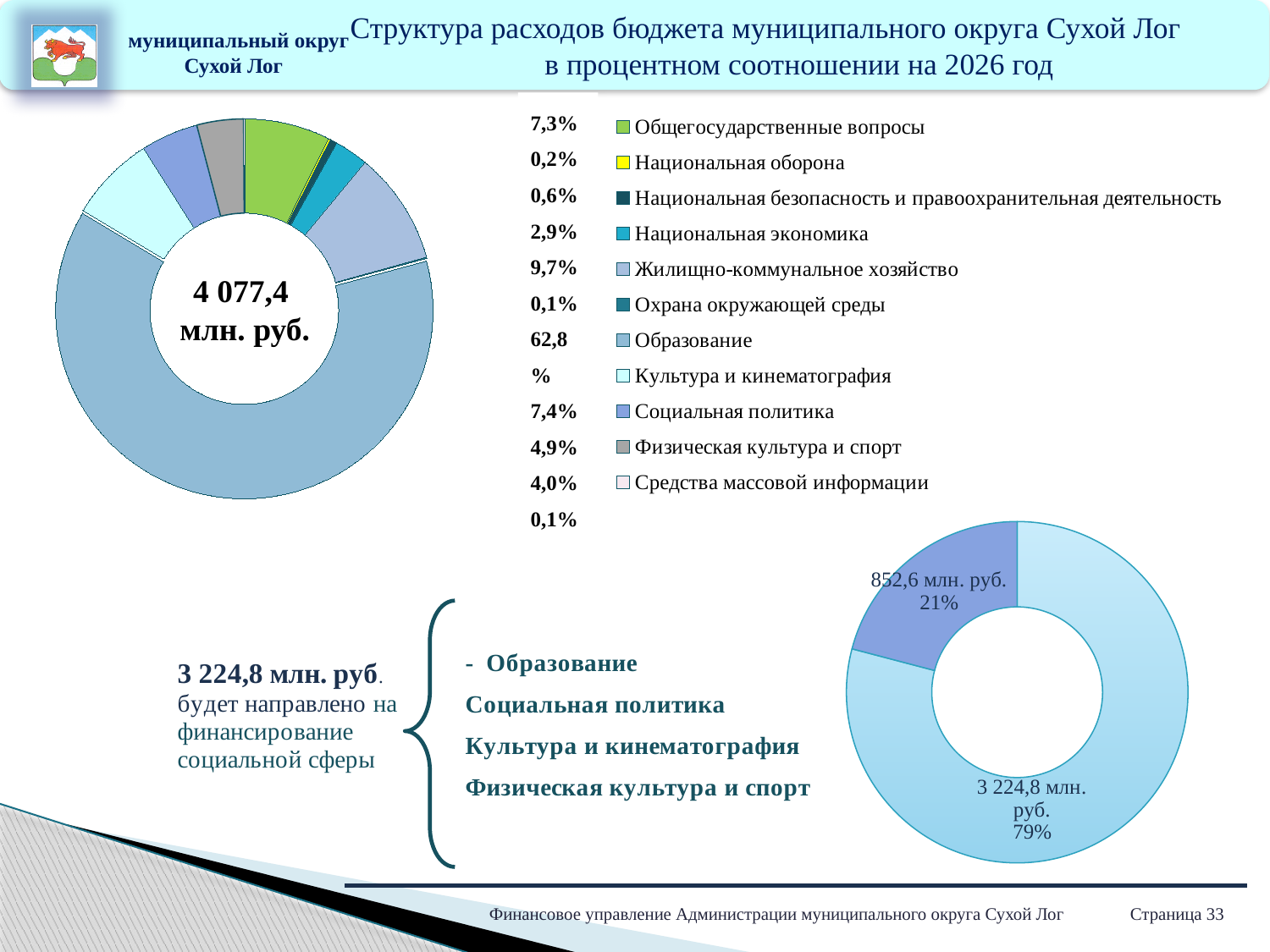
How many categories does the legend of the large doughnut chart on the left list? 11 What type of chart is the large chart on the left of the slide? doughnut (pie) chart In the large doughnut chart on the left, which category has the largest slice? Образование What total value is printed in the centre of the large doughnut chart on the left? 4 077,4 млн. руб. In the small doughnut chart at the bottom right, what value is shown for the larger slice? 3 224,8 млн. руб. In the large doughnut chart on the left, is the slice for Образование greater or less than 50%? greater In the small doughnut chart at the bottom right, what is the difference between the two slice values? 2 372,2 млн. руб. In the small doughnut chart at the bottom right, what share of the total does the 3 224,8 млн. руб. slice represent? 79% In the large doughnut chart on the left, what percentage is shown for Образование? 62,8 % In the small doughnut chart at the bottom right, what share of the total does the 852,6 млн. руб. slice represent? 21% How many slices does the small doughnut chart at the bottom right have? 2 In the small doughnut chart at the bottom right, what value is shown for the smaller slice? 852,6 млн. руб.